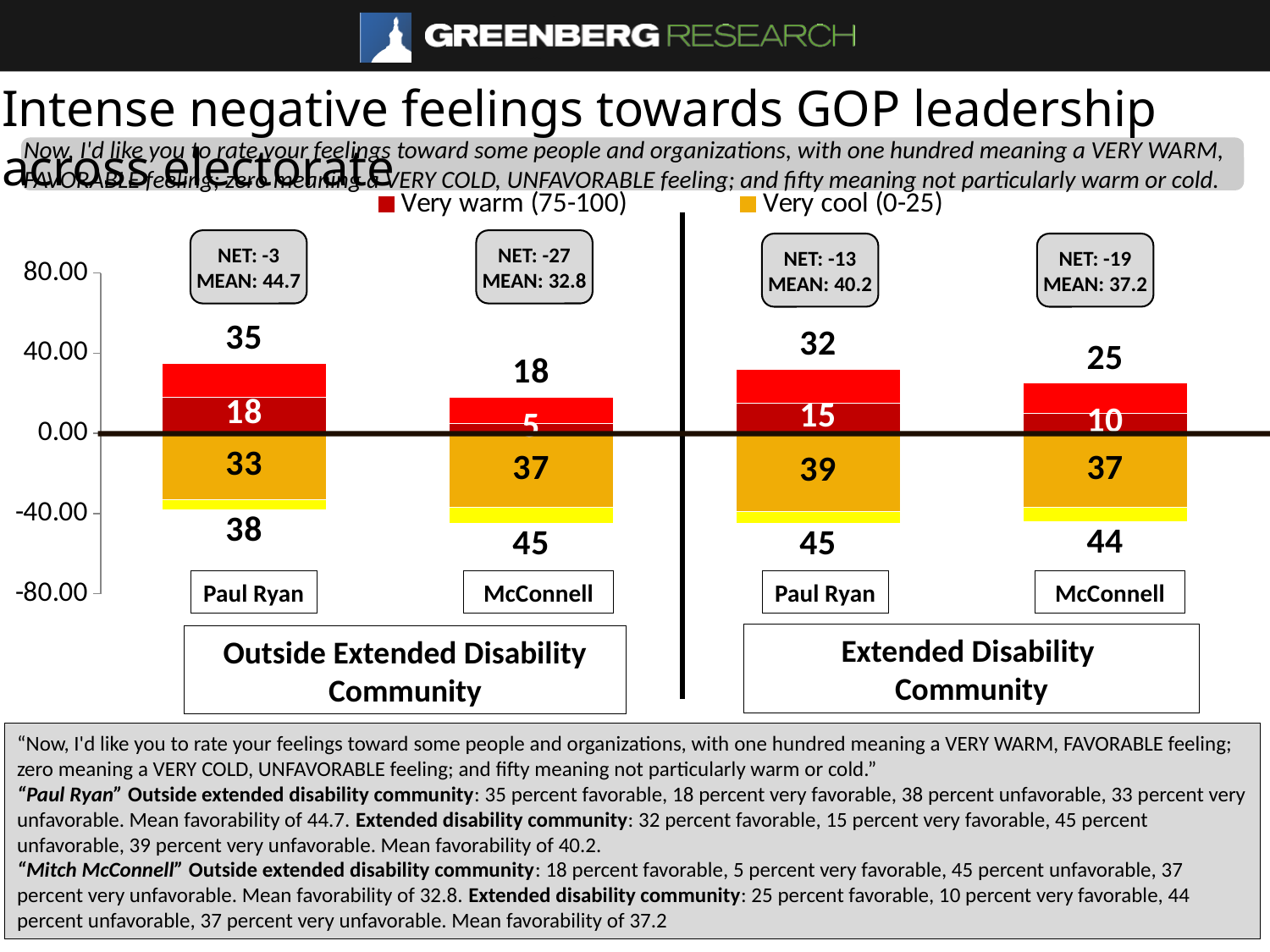
What kind of chart is shown on the slide? stacked bar chart How many series does the chart legend list? 2 What is the NET shown for Paul Ryan in the extended disability community? -13 Is the favorable percentage for Paul Ryan in the extended disability community larger or smaller than that for McConnell in the same group? larger What is the MEAN shown for McConnell among those outside the extended disability community? 32.8 What colour represents the 'Very cool (0-25)' series in the legend? orange What is the very warm (75-100) value for McConnell among those outside the extended disability community? 5 What is the very cool (0-25) value for Paul Ryan in the extended disability community? 39 What is the favorable (warm) percentage for Paul Ryan among those outside the extended disability community? 35 What is the unfavorable (cool) percentage for McConnell in the extended disability community? 44 What is the difference between the favorable percentage for Paul Ryan and for McConnell among those outside the extended disability community? 17 Which of the four bars has the lowest favorable (warm) percentage? McConnell, Outside Extended Disability Community